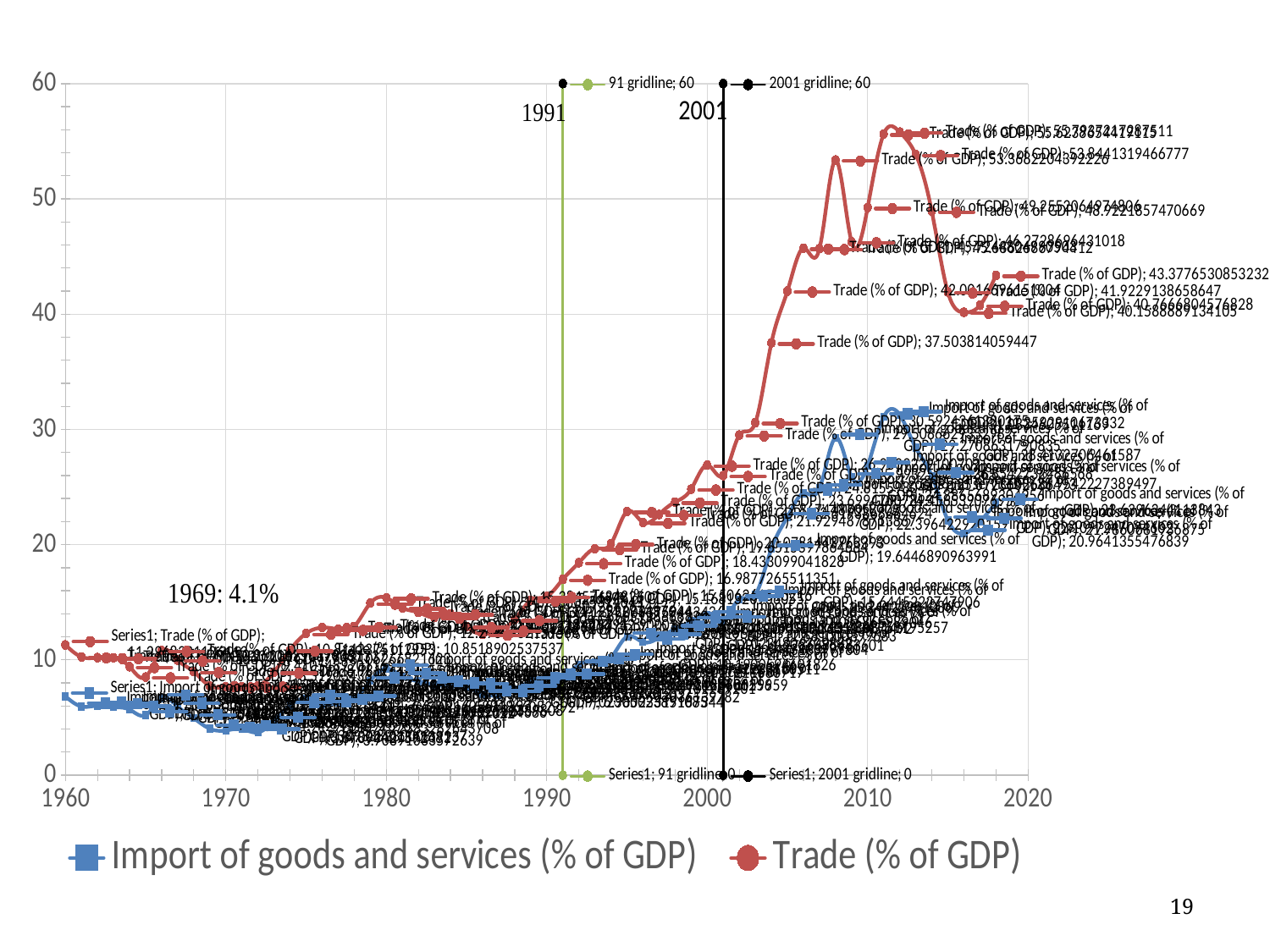
Does Import of goods and services (% of GDP) rise or fall between 1960 and 1970? fall Which years are marked by the two labelled vertical lines on the chart? 1991 and 2001 What kind of chart is shown on the slide? line chart Which two series are listed in the legend? Import of goods and services (% of GDP) and Trade (% of GDP) Is the value of Import of goods and services (% of GDP) in 1970 greater or less than 10? less Is the value of Trade (% of GDP) in 2010 greater or less than 40? greater Is the value of Trade (% of GDP) in 2005 greater or less than 30? greater Does Trade (% of GDP) generally rise or fall between 1990 and 2012? rise How many series does the legend list? 2 In 2010, which series has the higher value: Trade (% of GDP) or Import of goods and services (% of GDP)? Trade (% of GDP)